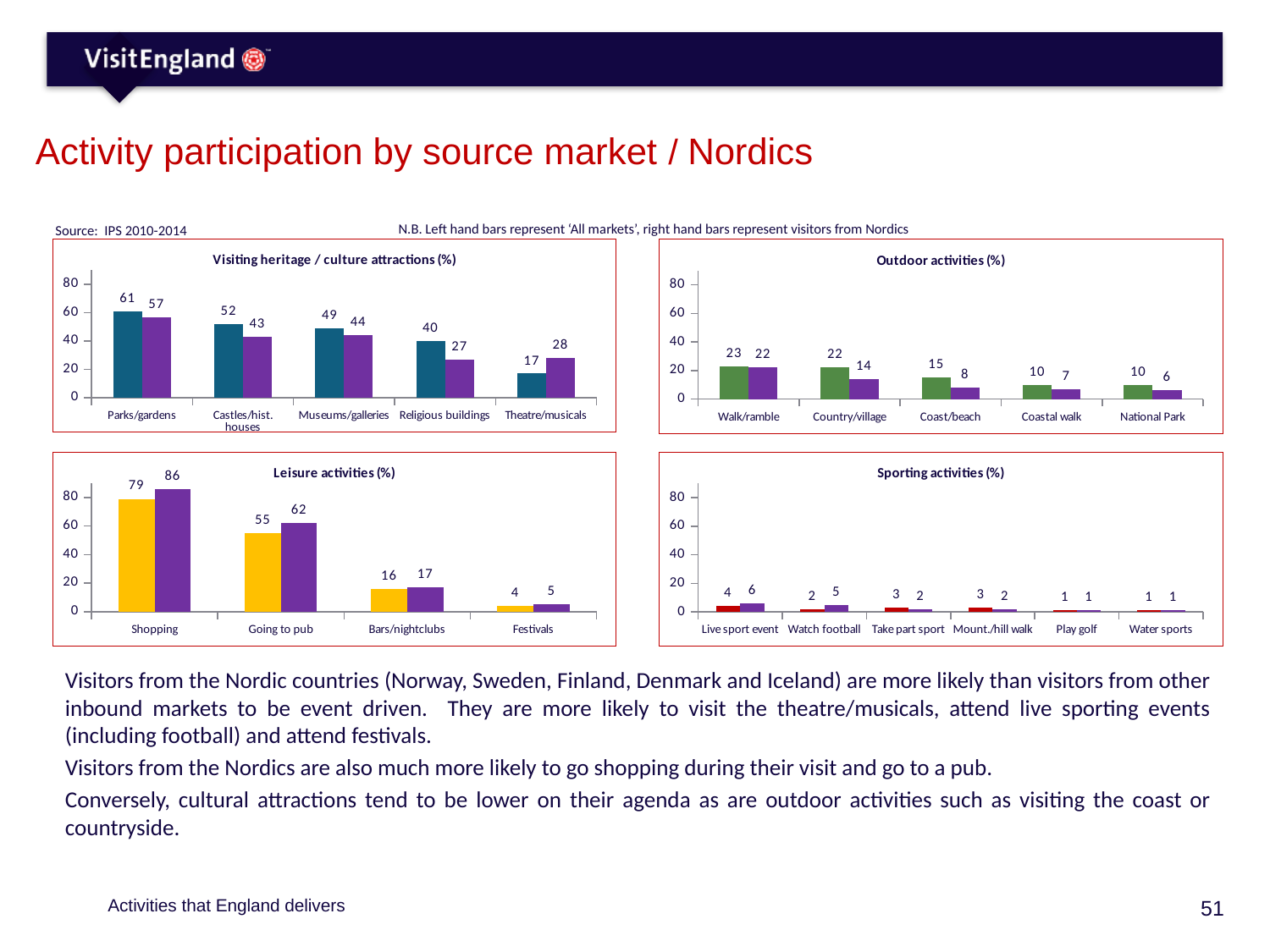
What type of chart is the 'Sporting activities (%)' chart? Bar chart In the 'Outdoor activities (%)' chart, how many categories are shown on the x axis? 5 In the 'Leisure activities (%)' chart, what is the value of the right-hand (Nordics) bar for Shopping? 86 In the 'Leisure activities (%)' chart, is the left-hand (All markets) bar for Going to pub greater or less than 60? less In the 'Sporting activities (%)' chart, how many categories are shown on the x axis? 6 In the 'Visiting heritage / culture attractions (%)' chart, what is the value of the right-hand (Nordics) bar for Theatre/musicals? 28 In the 'Outdoor activities (%)' chart, which category has the highest left-hand (All markets) bar? Walk/ramble In the 'Visiting heritage / culture attractions (%)' chart, what is the difference between the All markets and Nordics bars for Religious buildings? 13 In the 'Visiting heritage / culture attractions (%)' chart, what is the value of the left-hand (All markets) bar for Parks/gardens? 61 In the 'Leisure activities (%)' chart, which category has the lowest values? Festivals In the 'Outdoor activities (%)' chart, what is the value of the right-hand (Nordics) bar for Coast/beach? 8 In the 'Sporting activities (%)' chart, what is the value of the right-hand (Nordics) bar for Watch football? 5